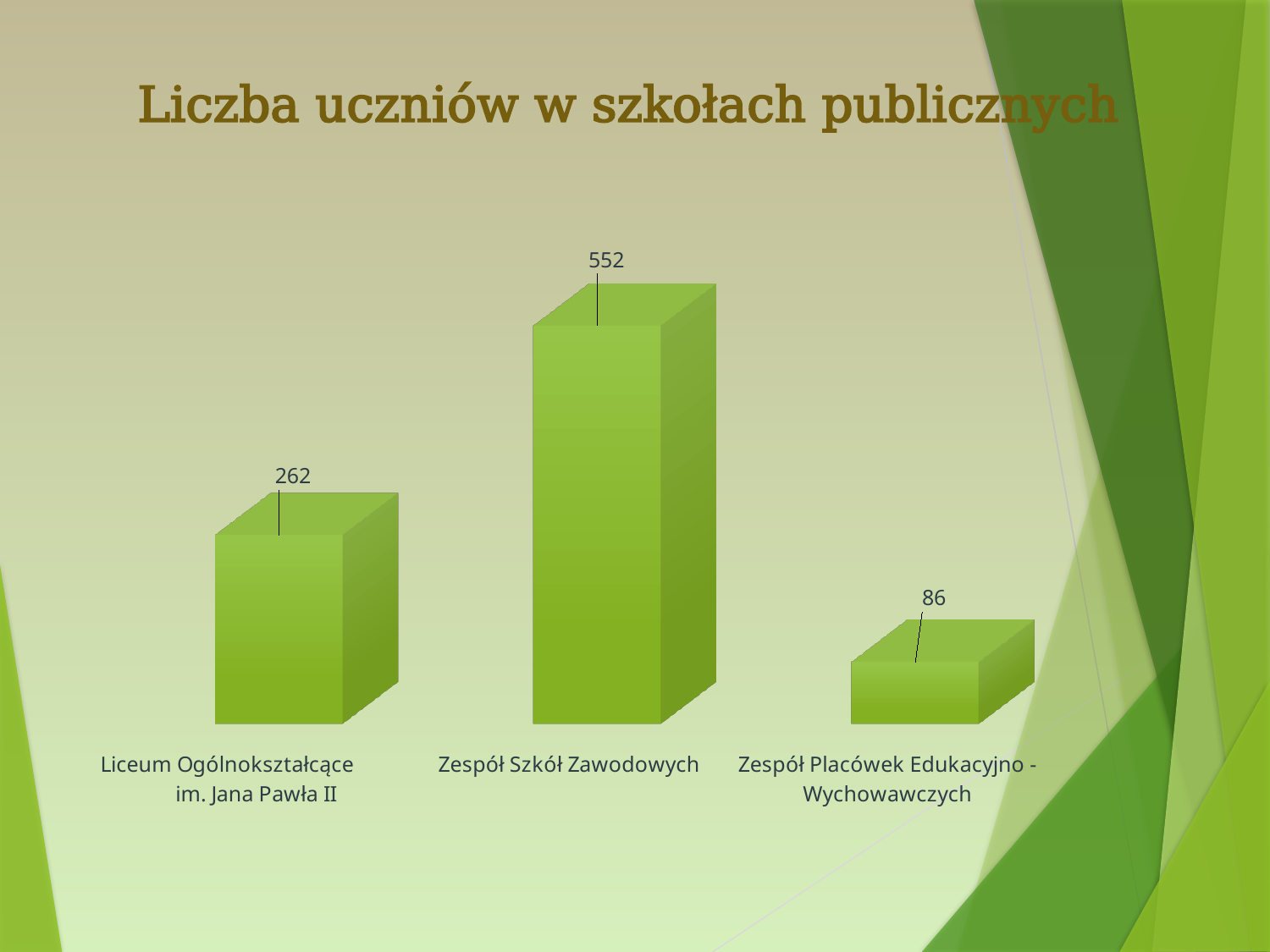
What kind of chart is shown on the slide? Bar chart What is the total number of students across all three schools shown? 900 What is the value shown for Zespół Placówek Edukacyjno - Wychowawczych? 86 How many students does the chart show for Liceum Ogólnokształcące im. Jana Pawła II? 262 Which school has the lowest number of students? Zespół Placówek Edukacyjno - Wychowawczych What is the difference between the values for Liceum Ogólnokształcące im. Jana Pawła II and Zespół Placówek Edukacyjno - Wychowawczych? 176 Which school has the highest number of students? Zespół Szkół Zawodowych What is the value shown for Zespół Szkół Zawodowych? 552 What is the difference between the values for Zespół Szkół Zawodowych and Liceum Ogólnokształcące im. Jana Pawła II? 290 How many schools are shown in the chart? 3 Which has more students, Liceum Ogólnokształcące im. Jana Pawła II or Zespół Placówek Edukacyjno - Wychowawczych? Liceum Ogólnokształcące im. Jana Pawła II What is the title of the slide? Liczba uczniów w szkołach publicznych